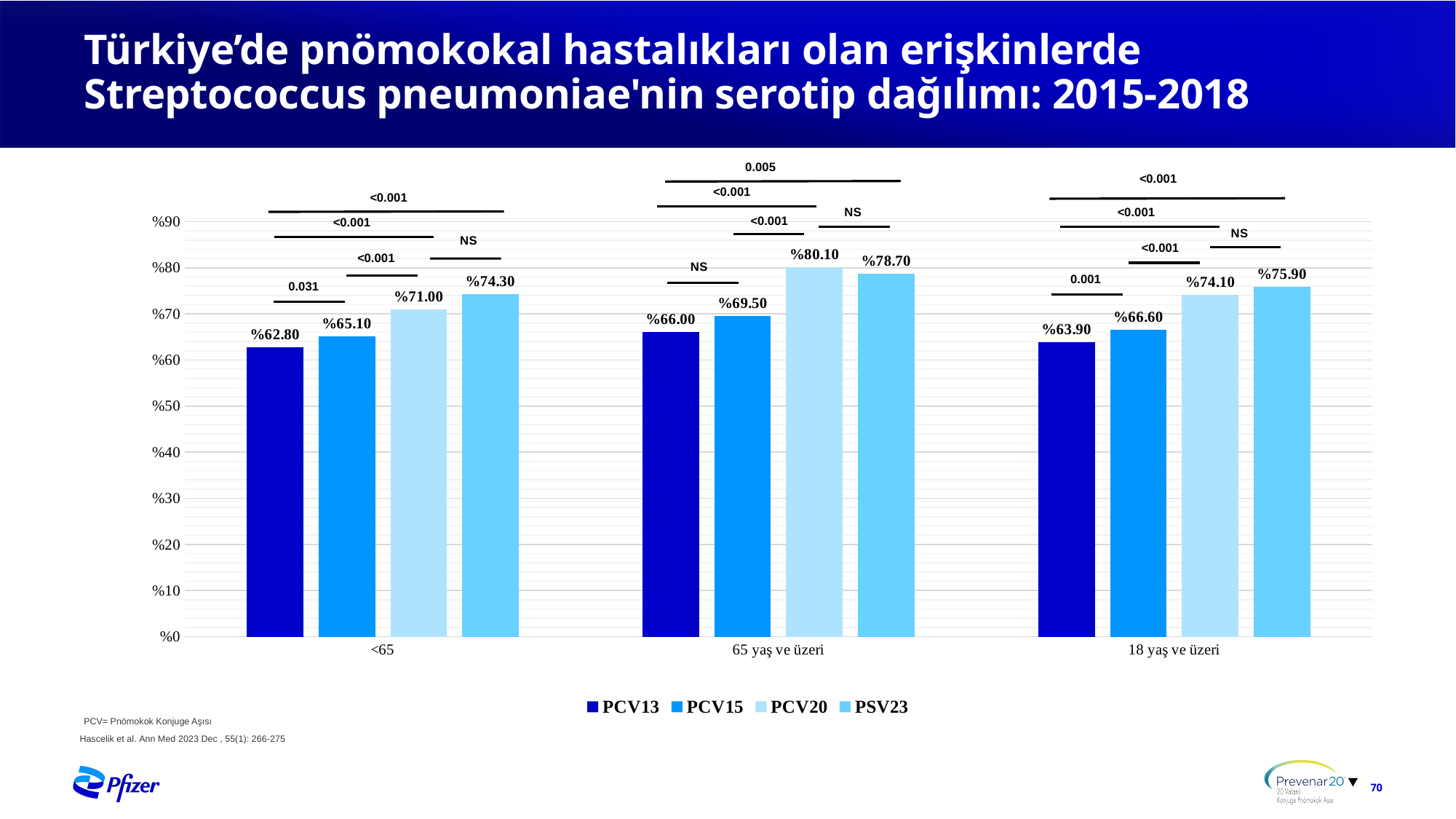
What is the value for PSV23 in the 18 yaş ve üzeri group? %75.90 Which series has the highest value in the 65 yaş ve üzeri group? PCV20 What is the value for PCV20 in the 65 yaş ve üzeri group? %80.10 What kind of chart is shown on the slide? Bar chart How many series does the legend list? 4 Which series is shown in the darkest blue colour? PCV13 What is the value for PCV13 in the <65 group? %62.80 Is the value for PCV15 in the 65 yaş ve üzeri group greater or less than %60? greater Which is larger in the 18 yaş ve üzeri group: PCV15 or PCV20? PCV20 Which series has the lowest value in the <65 group? PCV13 How many age-group categories are shown on the x axis? 3 What is the difference between the PSV23 and PCV13 values in the <65 group? 11.50 percentage points